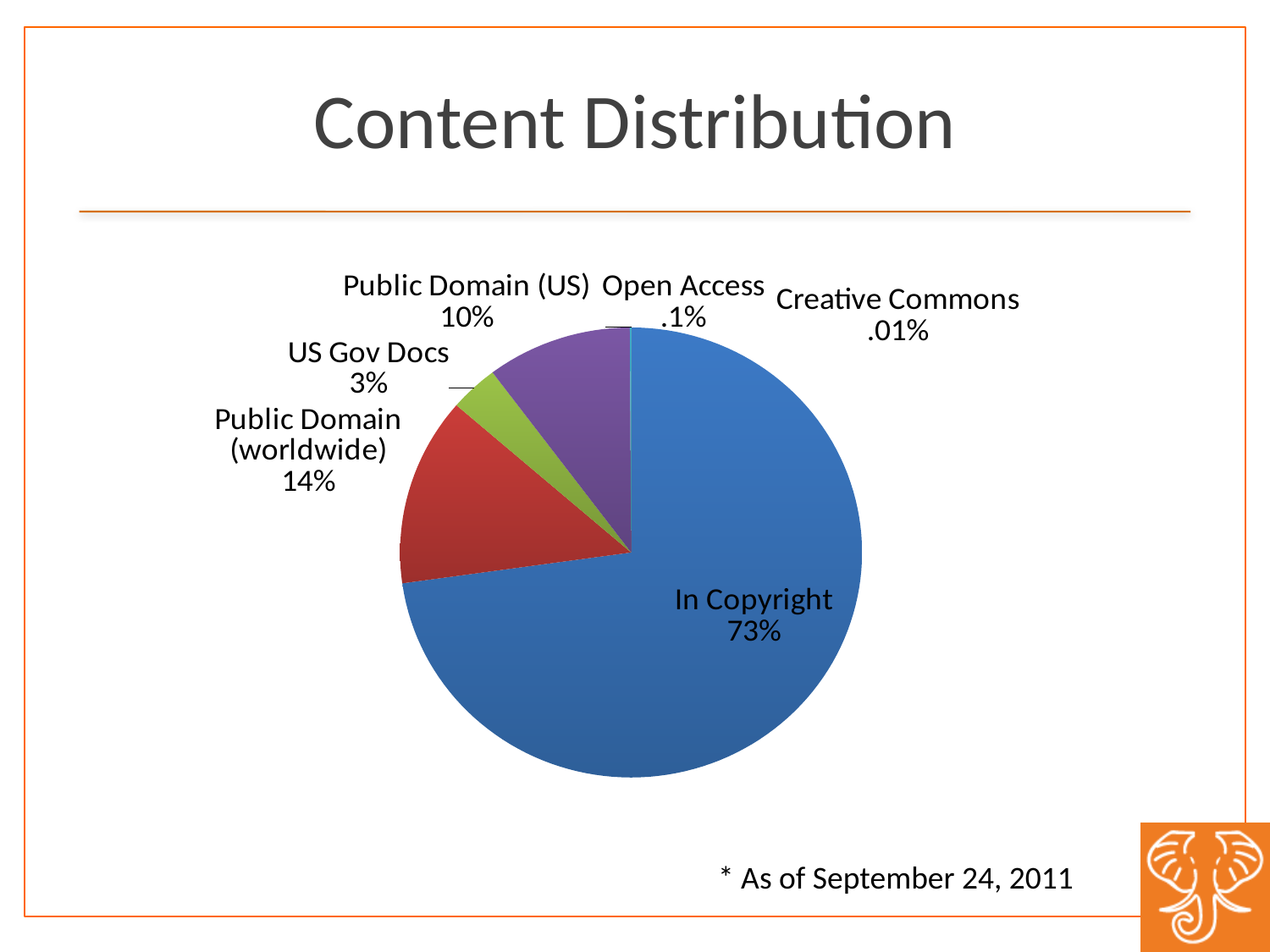
What is the difference in percentage points between In Copyright and Public Domain (worldwide)? 59 How many categories are shown in the pie chart? 6 Which is larger, Public Domain (worldwide) or Public Domain (US)? Public Domain (worldwide) What is the value shown for US Gov Docs? 3% What is the value shown for Creative Commons? .01% Which category has the smallest slice of the pie? Creative Commons What kind of chart is shown on the slide? Pie chart What is the value shown for Open Access? .1% Which category has the largest slice of the pie? In Copyright What is the value shown for Public Domain (US)? 10% What share of the pie does In Copyright hold? 73% What is the value shown for Public Domain (worldwide)? 14%